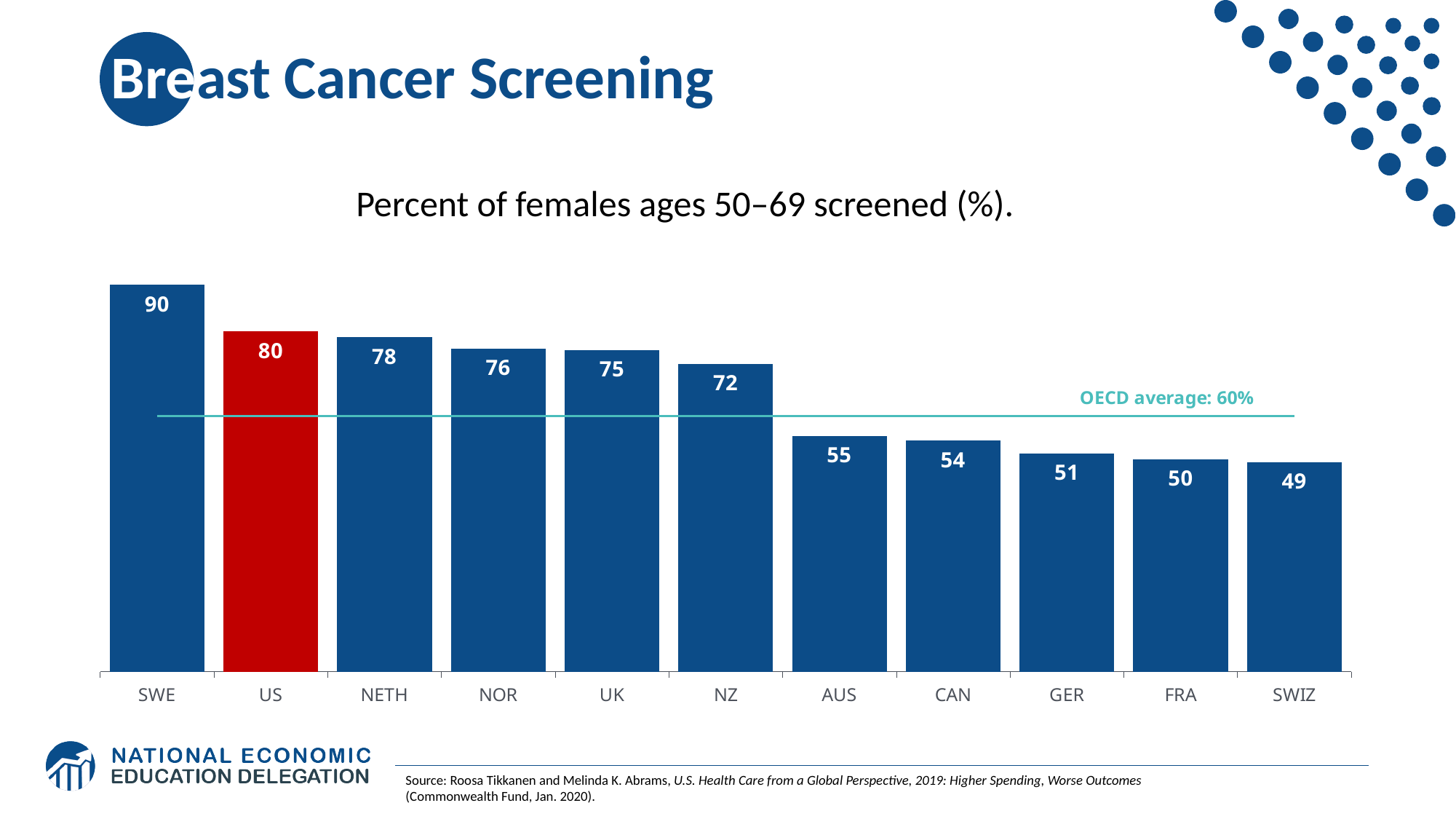
What is the value for NZ? 72 Which is larger, the value for NOR or the value for CAN? NOR What is the value for FRA? 50 Do the values rise or fall from left to right along the x axis? Fall How many countries are shown on the chart? 11 What OECD average is marked by the horizontal line on the chart? 60% What kind of chart is shown on the slide? Bar chart What is the difference between the values for SWE and the US? 10 What is the difference between the values for NETH and AUS? 23 What is the value for the US? 80 Which country has the highest value? SWE Which country has the lowest value? SWIZ